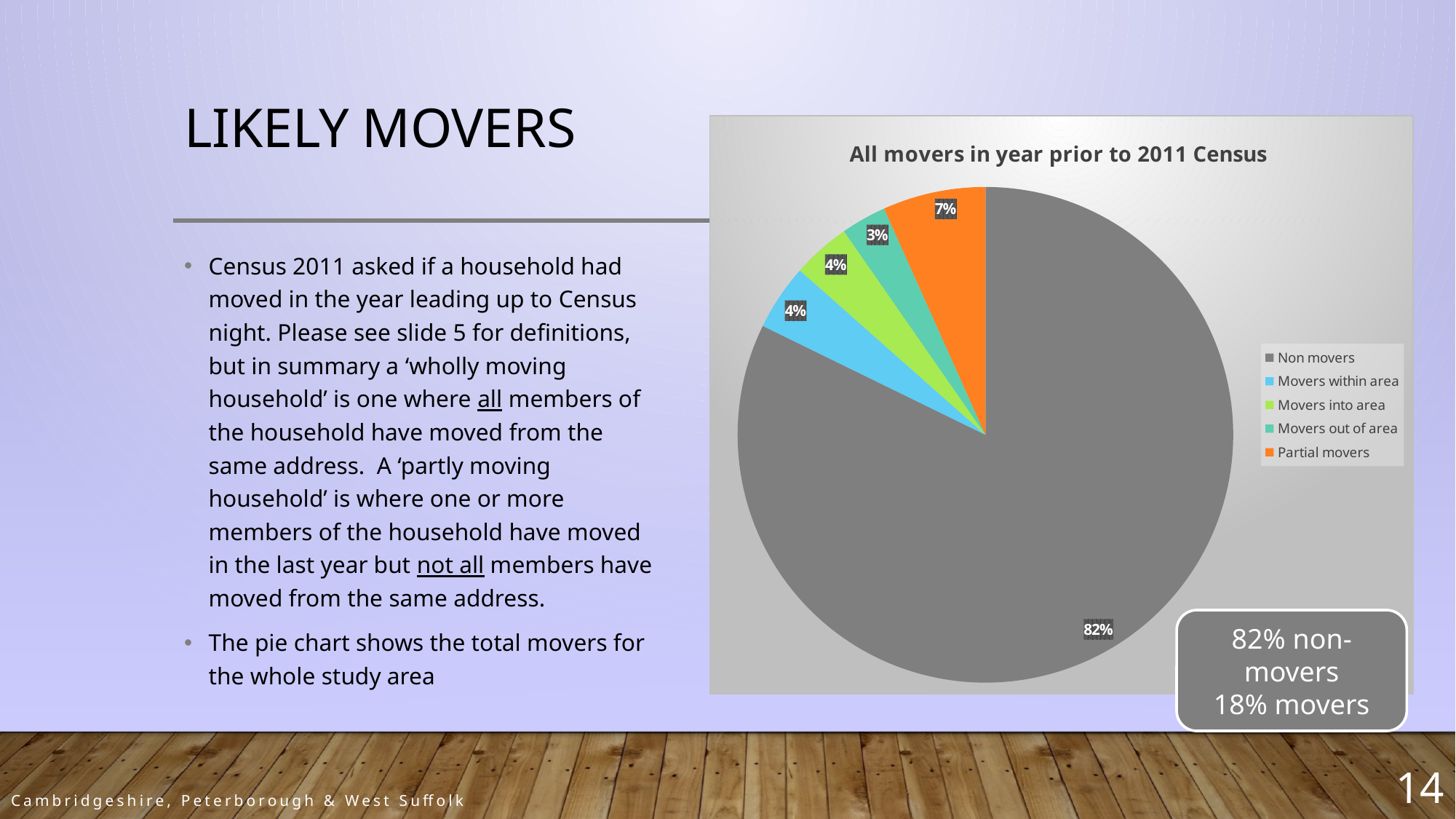
How many categories does the legend list? 5 Which category has the largest share of the pie? Non movers What colour represents Partial movers in the pie chart? orange Which is larger, the share for Partial movers or the share for Movers into area? Partial movers What is the title of the chart? All movers in year prior to 2011 Census What percentage of the pie is Non movers? 82% Which category has the smallest share of the pie? Movers out of area What percentage of the pie is Movers out of area? 3% What type of chart is shown on the slide? pie chart What percentage of the pie is Movers within area? 4% What is the difference between the Non movers share and the Partial movers share? 75% What percentage of the pie is Partial movers? 7%